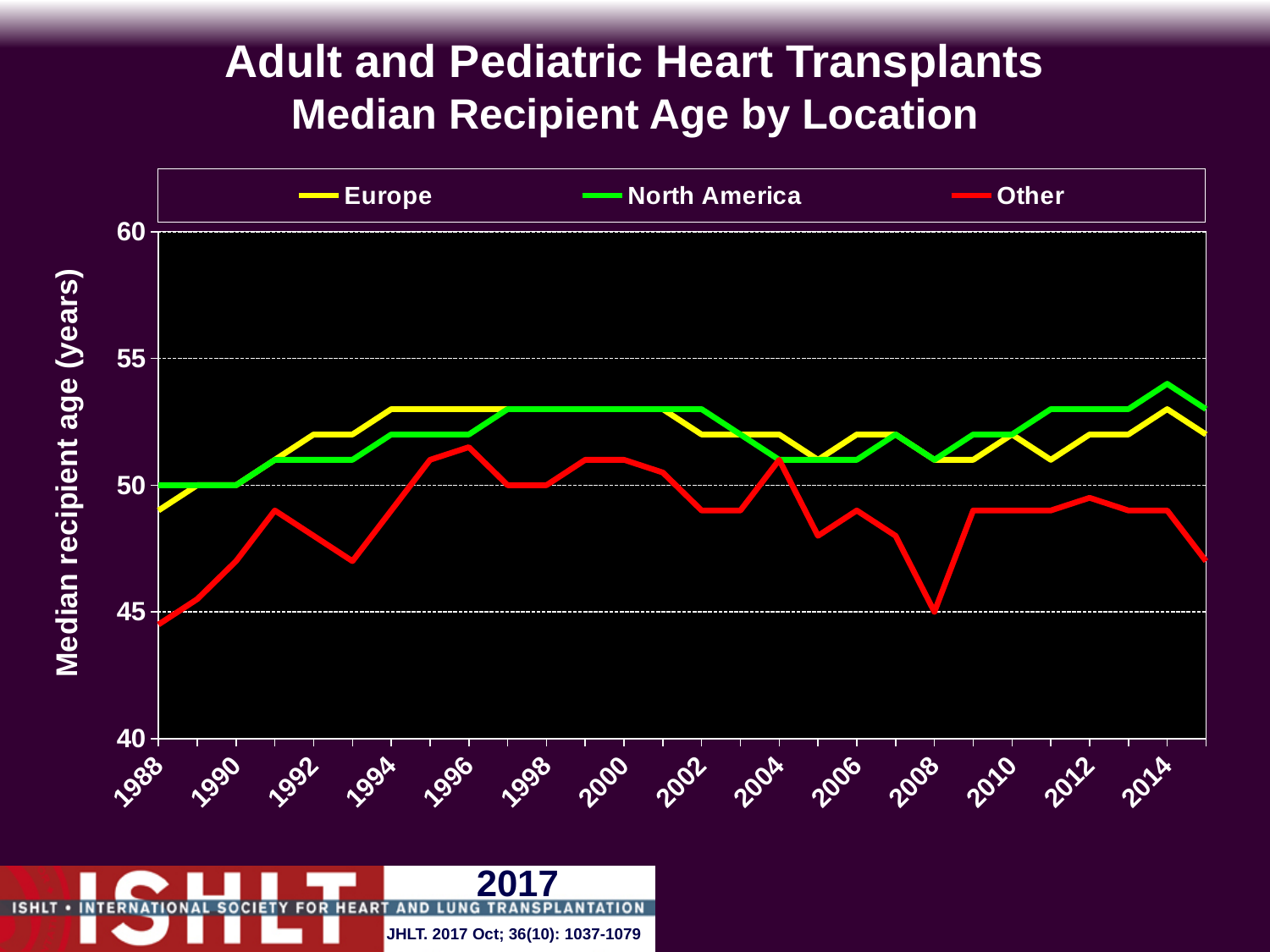
What kind of chart is shown on the slide? line chart Does the Other line rise or fall between 1988 and 1996? rise What is the median recipient age for Other in 2008? 45 Is the value for Europe in 1995 greater or less than 50? greater Is the value for North America in 2014 greater or less than 55? less In 2008, which series has the larger value, Europe or Other? Europe How many series does the legend list? 3 What colour is the Europe line? yellow What is the label of the y axis? Median recipient age (years) Is the value for Other in 1993 greater or less than 50? less In which year does the North America line reach its highest value? 2014 What is the median recipient age for North America in 1988? 50